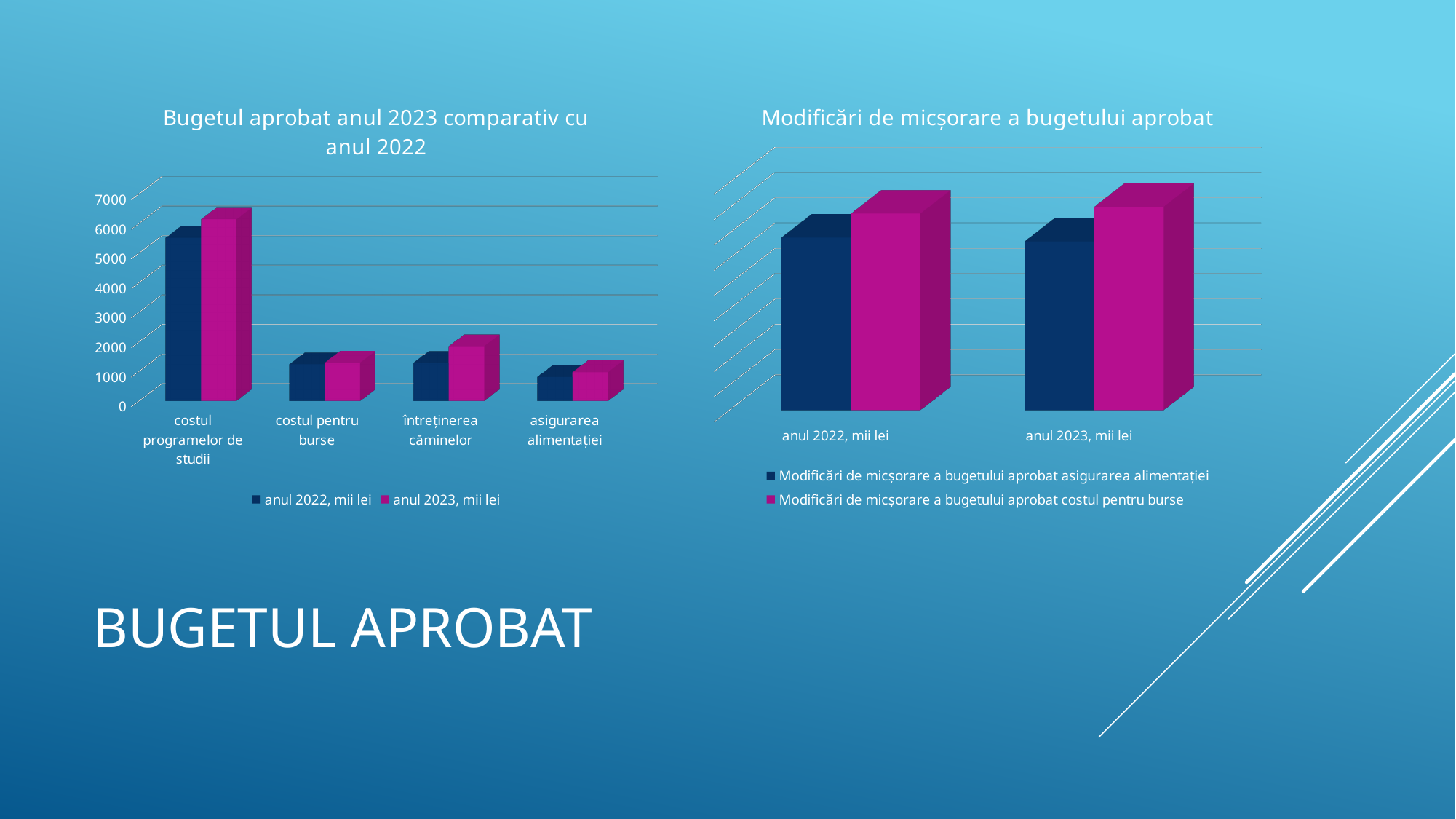
In the left chart "Bugetul aprobat anul 2023 comparativ cu anul 2022", which colour represents the series anul 2023, mii lei? magenta In the left chart "Bugetul aprobat anul 2023 comparativ cu anul 2022", which category has the highest value for anul 2023, mii lei? costul programelor de studii What kind of chart is the left chart titled "Bugetul aprobat anul 2023 comparativ cu anul 2022"? bar chart In the right chart "Modificări de micșorare a bugetului aprobat", for anul 2023, mii lei, which series has the larger value: asigurarea alimentației or costul pentru burse? Modificări de micșorare a bugetului aprobat costul pentru burse In the right chart "Modificări de micșorare a bugetului aprobat", how many categories are shown on the x axis? 2 In the left chart "Bugetul aprobat anul 2023 comparativ cu anul 2022", is the value for costul programelor de studii in anul 2022, mii lei greater or less than 4000? greater In the left chart "Bugetul aprobat anul 2023 comparativ cu anul 2022", how many categories are shown on the x axis? 4 What is the title of the right chart? Modificări de micșorare a bugetului aprobat In the left chart "Bugetul aprobat anul 2023 comparativ cu anul 2022", is the value for întreținerea căminelor in anul 2023, mii lei greater or less than 3000? less In the left chart "Bugetul aprobat anul 2023 comparativ cu anul 2022", which category has the lowest value for anul 2022, mii lei? asigurarea alimentației In the left chart "Bugetul aprobat anul 2023 comparativ cu anul 2022", how many series does the legend list? 2 In the left chart "Bugetul aprobat anul 2023 comparativ cu anul 2022", for întreținerea căminelor, which series has the larger value: anul 2022, mii lei or anul 2023, mii lei? anul 2023, mii lei